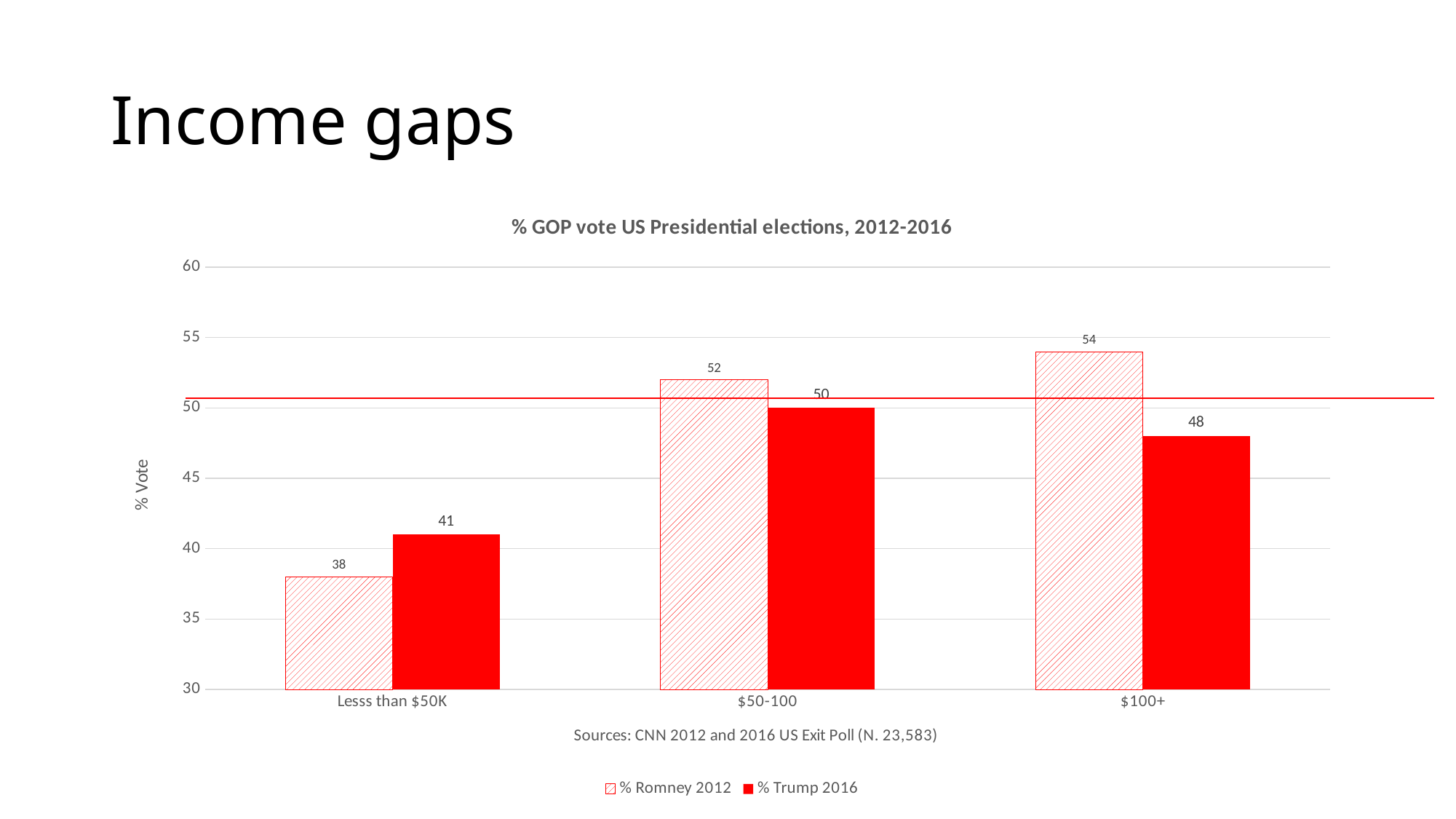
How many series does the legend list? 2 Do the % Trump 2016 values rise or fall from Lesss than $50K to $100+? Rise For the Lesss than $50K category, which is larger: % Romney 2012 or % Trump 2016? % Trump 2016 What is the % Trump 2016 value for the $100+ category? 48 How many income categories are shown on the x axis? 3 What is the difference between the % Romney 2012 and % Trump 2016 values for the $100+ category? 6 What is the % Trump 2016 value for the $50-100 category? 50 What is the title of the chart? % GOP vote US Presidential elections, 2012-2016 Which income category has the highest % Romney 2012 value? $100+ What kind of chart is shown on the slide? Bar chart Which income category has the lowest % Trump 2016 value? Lesss than $50K What is the % Romney 2012 value for the Lesss than $50K category? 38